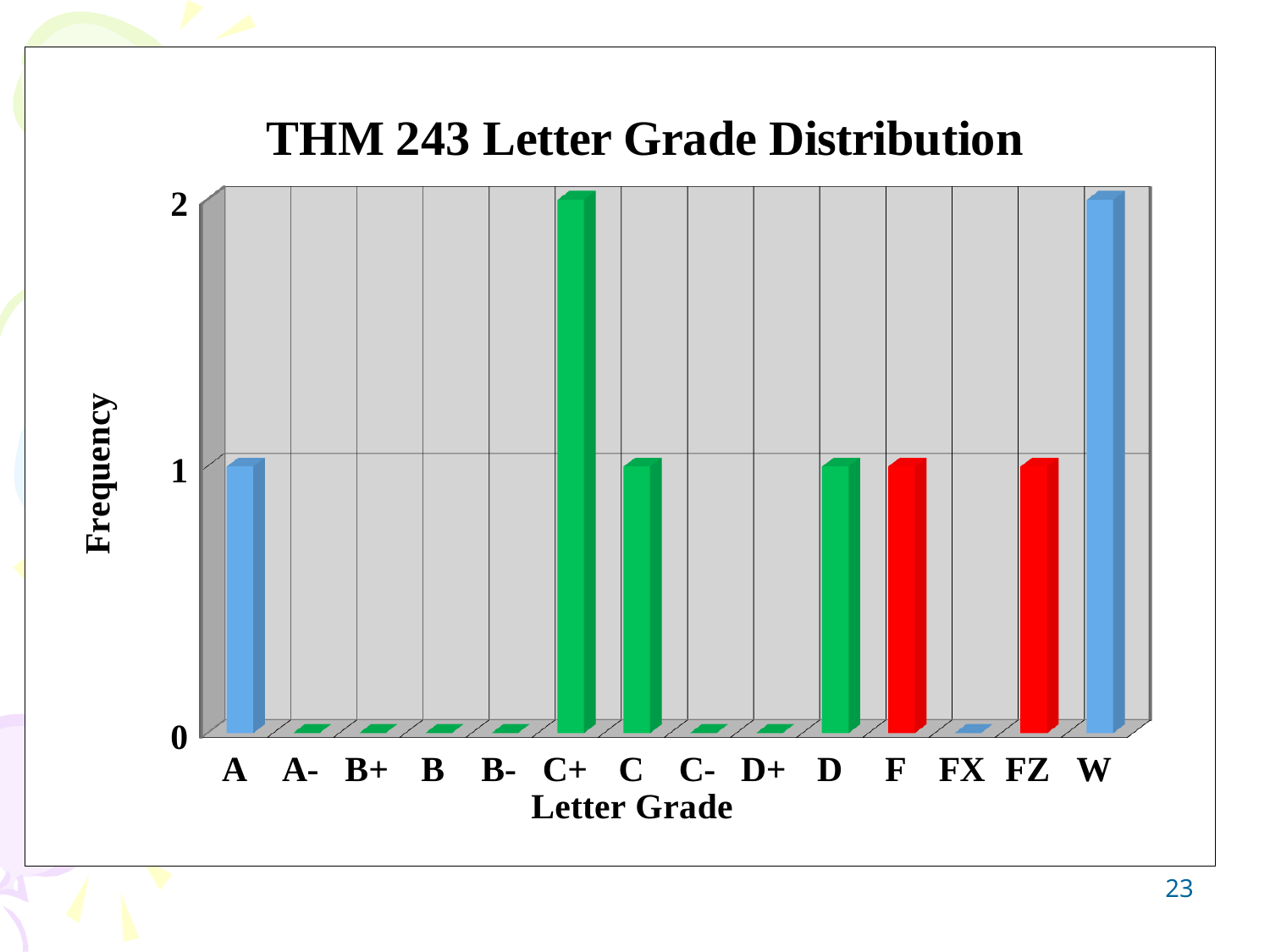
What is the frequency for letter grade FZ? 1 What is the frequency for letter grade A? 1 What is the difference between the frequency for C+ and the frequency for C? 1 How many letter grade categories are shown on the x axis? 14 Which has a higher frequency, C+ or D? C+ What is the title of the chart? THM 243 Letter Grade Distribution What is the frequency for letter grade C+? 2 What is the frequency for letter grade W? 2 What kind of chart is shown on the slide? Bar chart What is the frequency for letter grade B? 0 Which two letter grades have the highest frequency? C+ and W Which has a higher frequency, F or FX? F